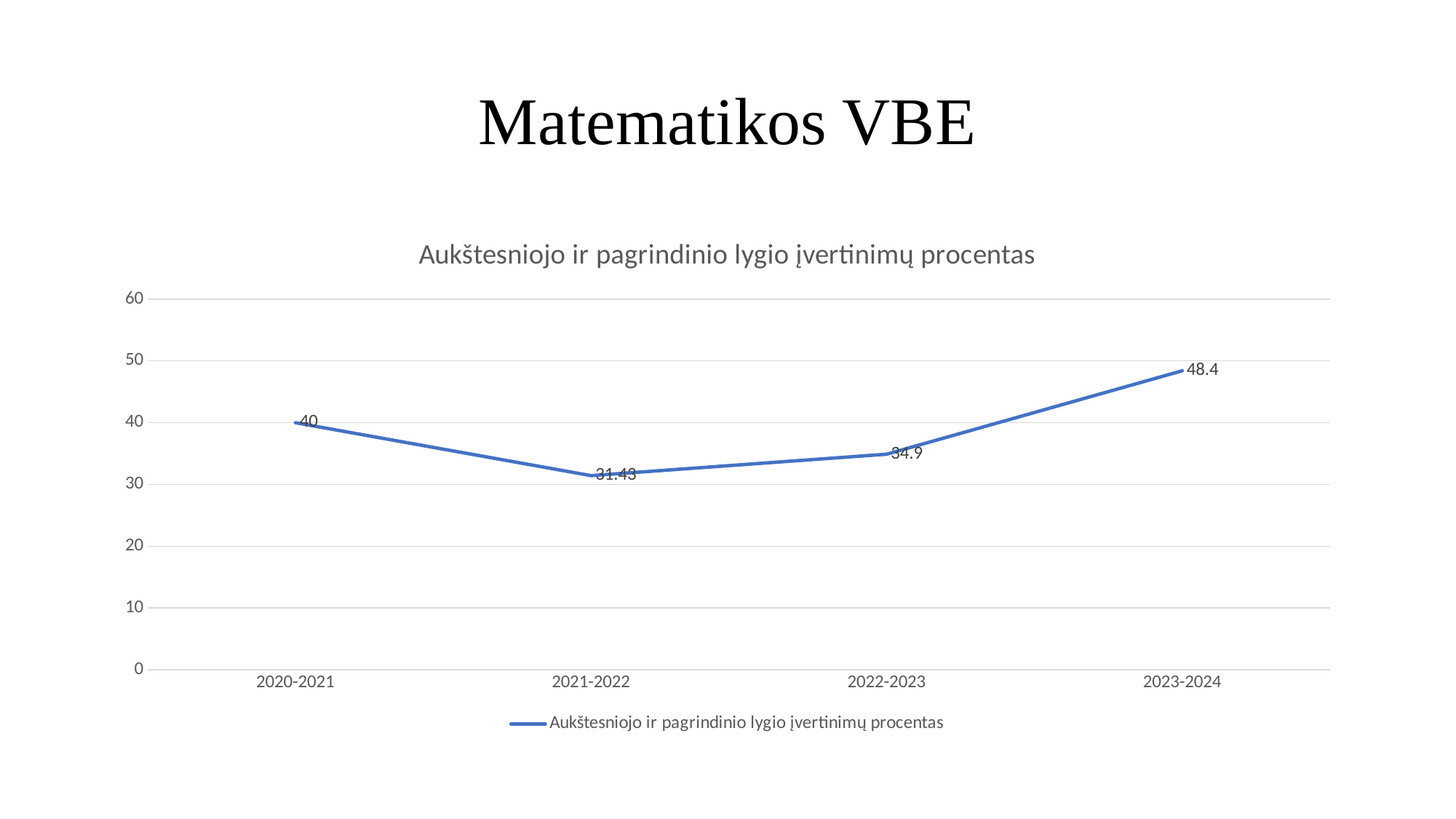
Which school year has the highest value? 2023-2024 What is the title of the chart? Aukštesniojo ir pagrindinio lygio įvertinimų procentas Which is larger, the value for 2020-2021 or the value for 2022-2023? 2020-2021 What is the value for 2021-2022? 31.43 What is the value for 2020-2021? 40 What is the difference between the values for 2023-2024 and 2020-2021? 8.4 What is the value for 2023-2024? 48.4 What is the value for 2022-2023? 34.9 Is the value for 2023-2024 greater or less than 50? less What kind of chart is shown on the slide? line chart How many school years are plotted on the x axis? 4 Which school year has the lowest value? 2021-2022